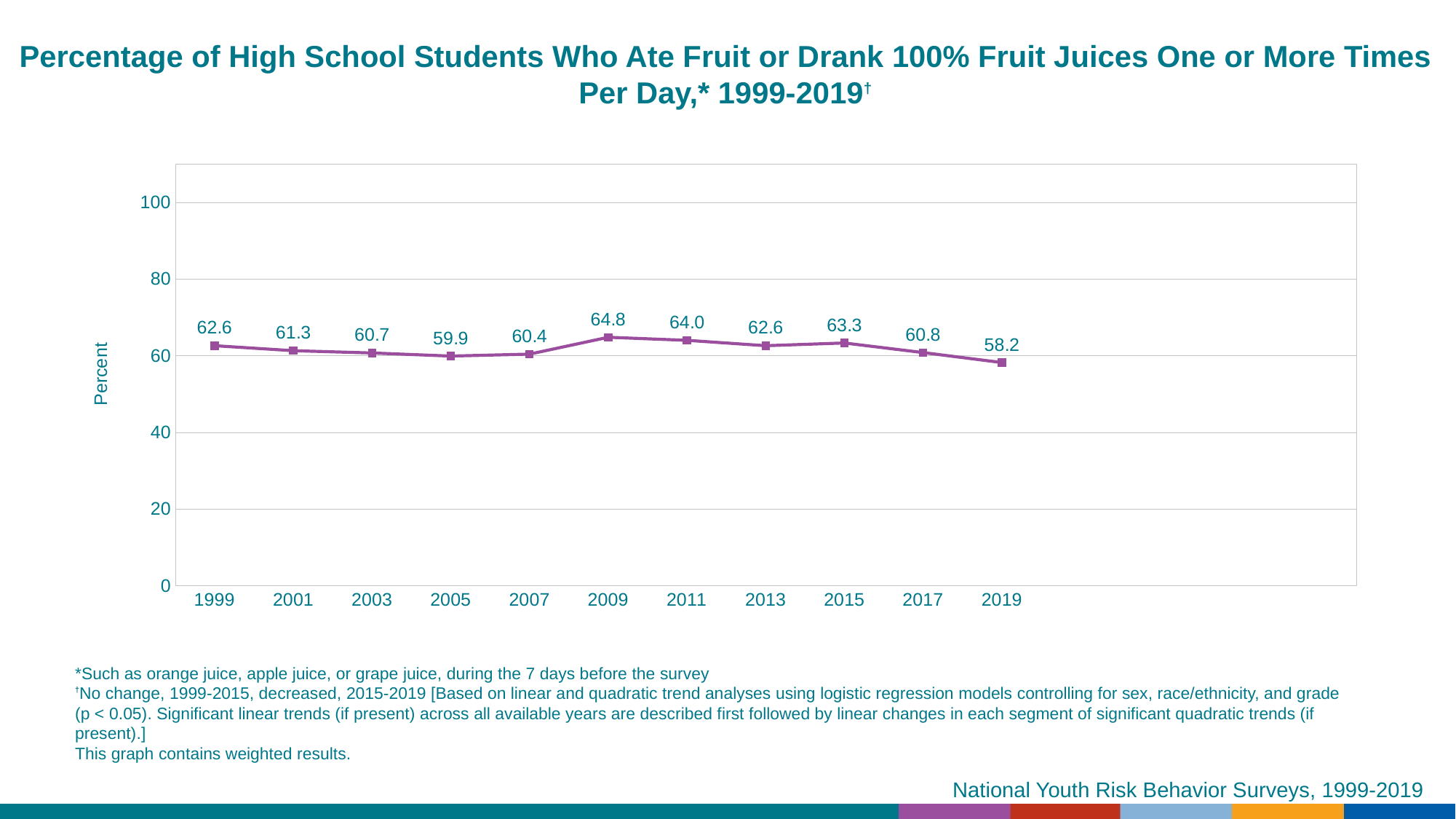
Is the value for 2005 greater or less than 60? less Which is larger, the value for 2011 or the value for 2013? 2011 What is the value for 2019? 58.2 Which year has the lowest value? 2019 What is the value for 2009? 64.8 What kind of chart is shown? line chart What is the difference between the values for 2015 and 2019? 5.1 What is the value for 1999? 62.6 How many years are plotted on the chart? 11 Do the values rise or fall from 2015 to 2019? fall Which year has the highest value? 2009 What is the label on the y axis? Percent